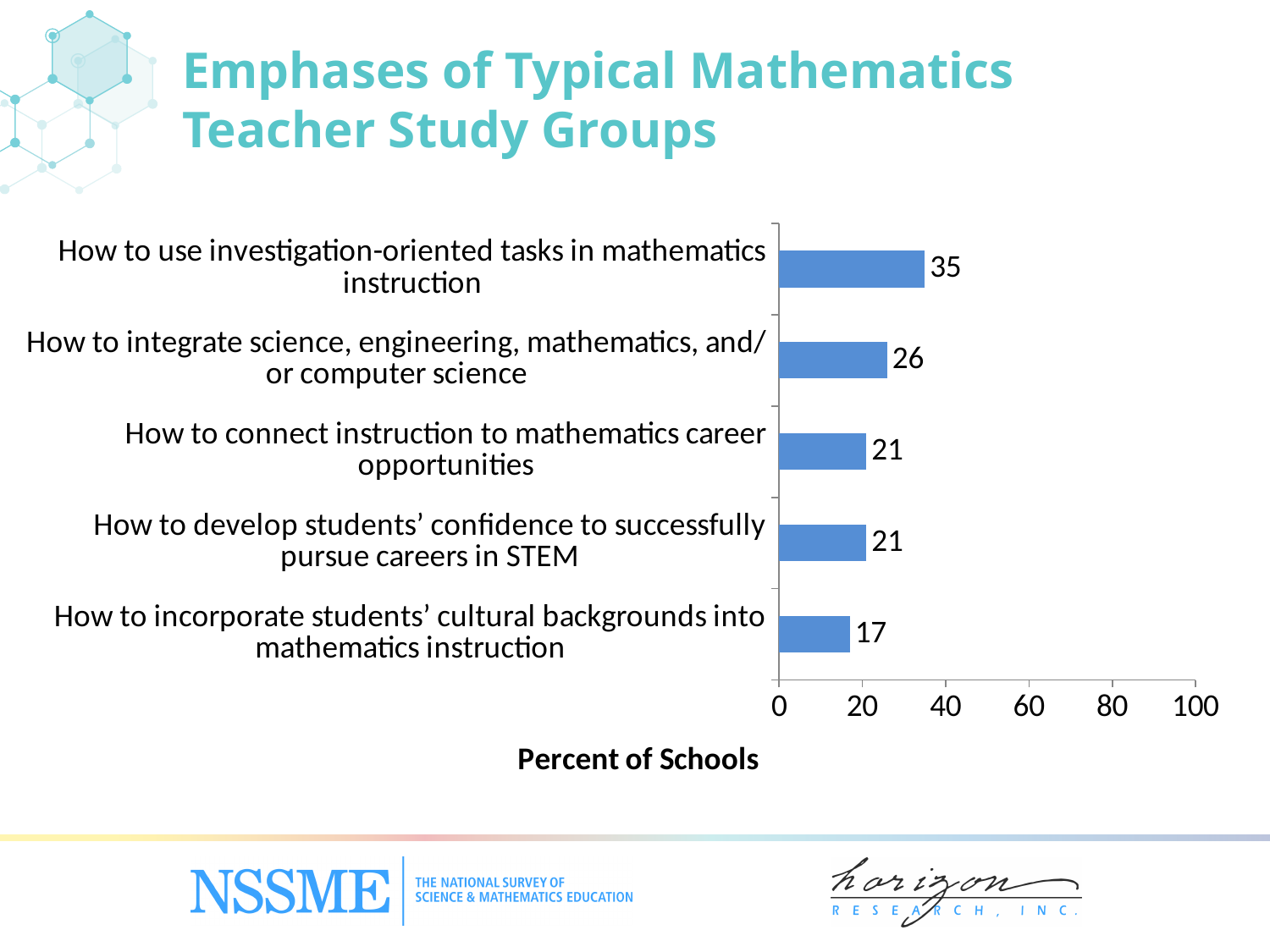
What is the value for 'How to incorporate students' cultural backgrounds into mathematics instruction'? 17 What percent of schools reported study groups emphasizing how to use investigation-oriented tasks in mathematics instruction? 35 How many categories are shown in the chart? 5 What is the difference between the value for integrating science, engineering, mathematics, and/or computer science and the value for connecting instruction to mathematics career opportunities? 5 Which is larger: the value for integrating science, engineering, mathematics, and/or computer science, or the value for developing students' confidence to pursue careers in STEM? How to integrate science, engineering, mathematics, and/or computer science Which category has the lowest percent of schools? How to incorporate students' cultural backgrounds into mathematics instruction Which category has the highest percent of schools? How to use investigation-oriented tasks in mathematics instruction What is the value for 'How to connect instruction to mathematics career opportunities'? 21 What is the difference between the value for investigation-oriented tasks and the value for incorporating students' cultural backgrounds? 18 What type of chart is shown on the slide? Bar chart What is the value for 'How to integrate science, engineering, mathematics, and/or computer science'? 26 Is the value for 'How to use investigation-oriented tasks in mathematics instruction' greater or less than 40? less